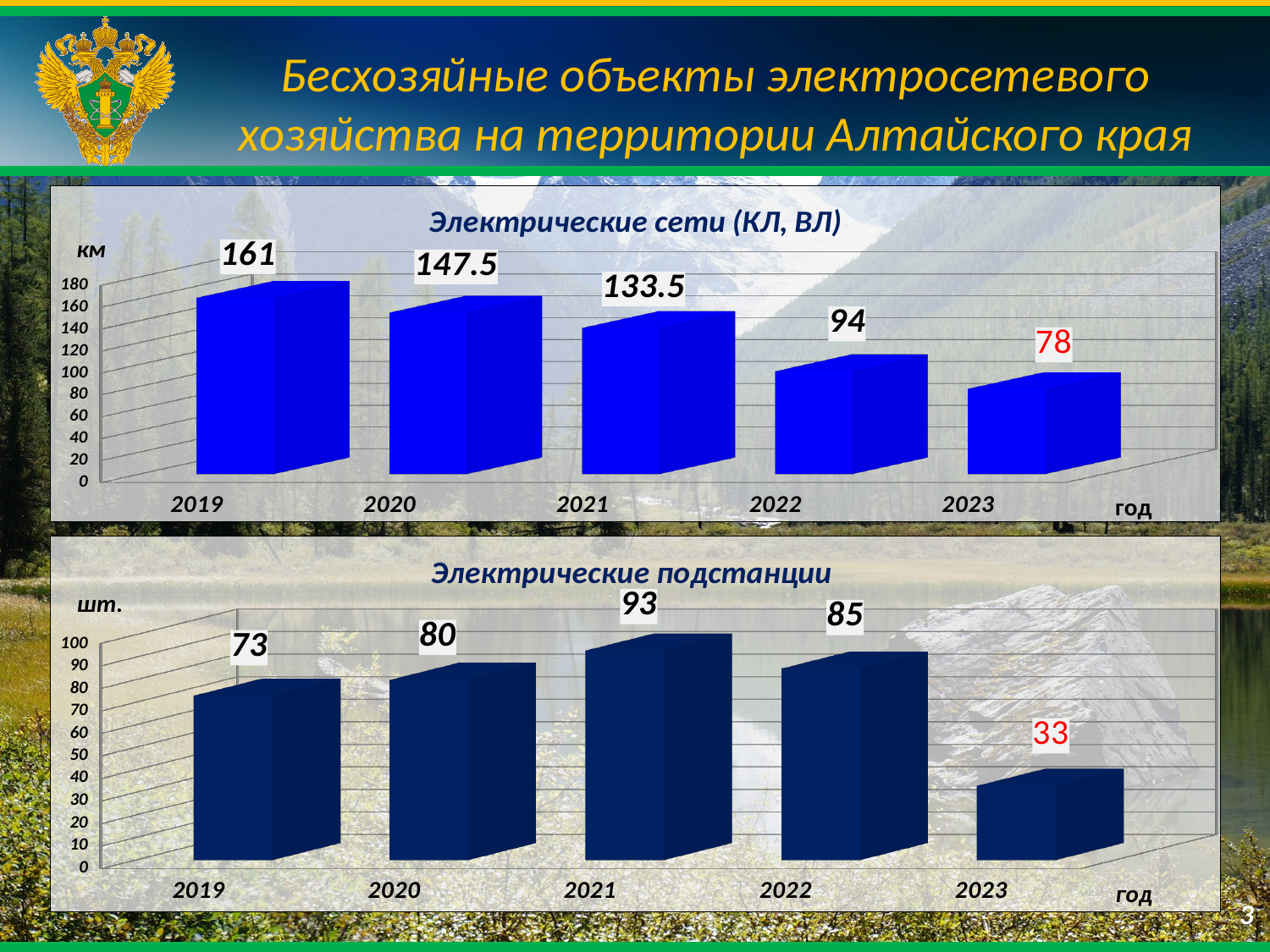
In the chart titled 'Электрические подстанции', how many years are shown on the x axis? 5 What kind of chart is the chart titled 'Электрические сети (КЛ, ВЛ)'? bar chart What unit is shown on the vertical axis of the chart titled 'Электрические подстанции'? шт. In the chart titled 'Электрические сети (КЛ, ВЛ)', do the values rise or fall from 2019 to 2023? fall In the chart titled 'Электрические подстанции', which is larger, the value for 2020 or the value for 2022? 2022 In the chart titled 'Электрические сети (КЛ, ВЛ)', what is the value for 2023? 78 In the chart titled 'Электрические подстанции', what is the difference between the values for 2022 and 2023? 52 In the chart titled 'Электрические подстанции', which year has the highest value? 2021 In the chart titled 'Электрические сети (КЛ, ВЛ)', what is the difference between the values for 2020 and 2021? 14 In the chart titled 'Электрические сети (КЛ, ВЛ)', what is the value for 2019? 161 In the chart titled 'Электрические сети (КЛ, ВЛ)', which year has the lowest value? 2023 In the chart titled 'Электрические подстанции', what is the value for 2021? 93